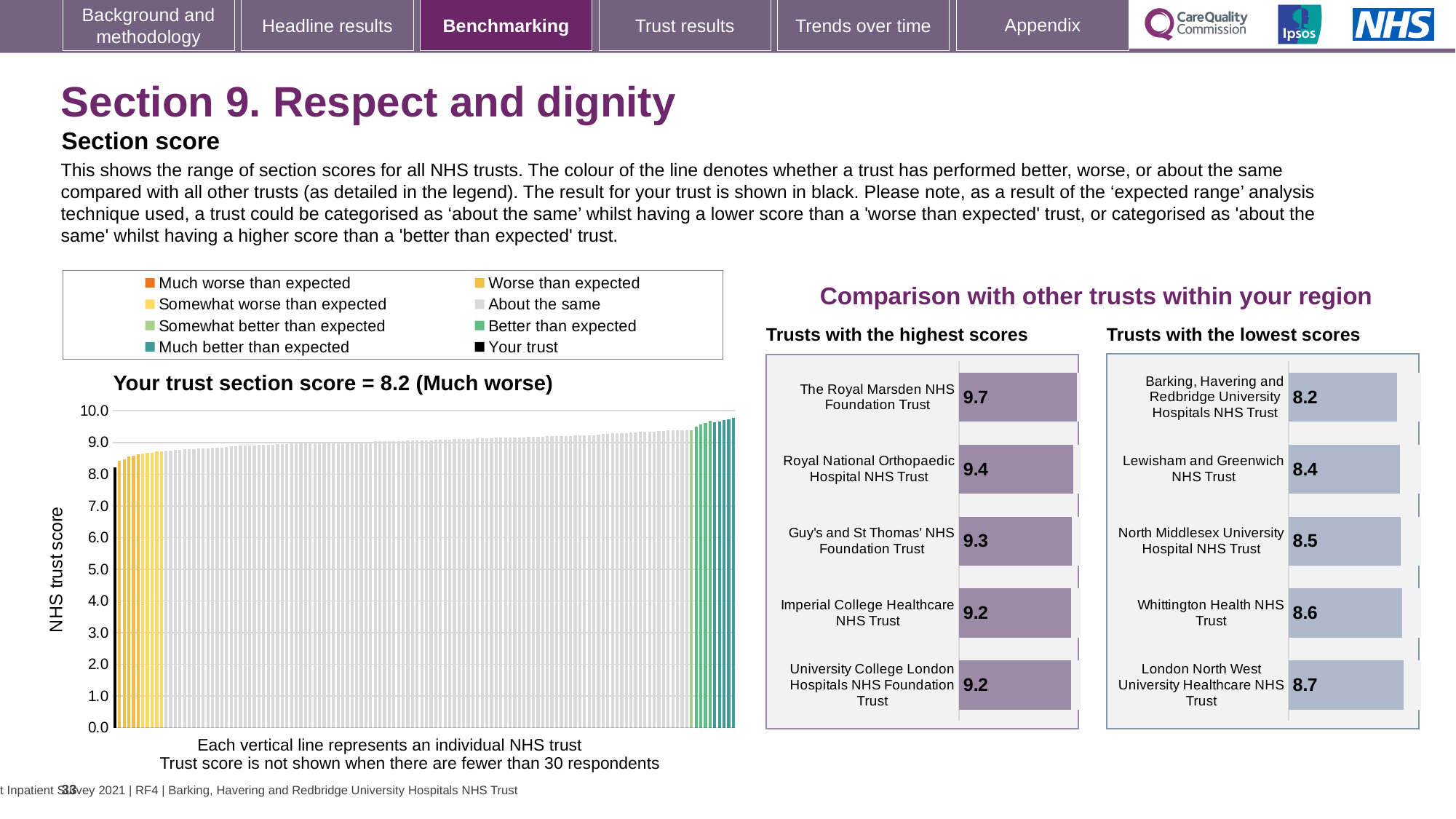
In the 'Trusts with the highest scores' chart, what is the difference between the scores of The Royal Marsden NHS Foundation Trust and Royal National Orthopaedic Hospital NHS Trust? 0.3 In the 'Trusts with the lowest scores' chart, which has the higher score: Whittington Health NHS Trust or Lewisham and Greenwich NHS Trust? Whittington Health NHS Trust In the 'Trusts with the lowest scores' chart, what is the difference between the scores of London North West University Healthcare NHS Trust and Barking, Havering and Redbridge University Hospitals NHS Trust? 0.5 In the 'Trusts with the lowest scores' chart, which trust has the lowest score? Barking, Havering and Redbridge University Hospitals NHS Trust In the 'Your trust section score' chart on the left, is the value of the tallest bar greater or less than 9.0? greater How many trusts are shown in the 'Trusts with the highest scores' chart? 5 How many entries does the legend above the 'Your trust section score' chart list? 8 In the 'Your trust section score' chart on the left, what is the section score for your trust? 8.2 In the 'Trusts with the highest scores' chart, what is the score for Guy's and St Thomas' NHS Foundation Trust? 9.3 In the 'Trusts with the highest scores' chart, what is the score for The Royal Marsden NHS Foundation Trust? 9.7 In the 'Trusts with the highest scores' chart, which trust has the highest score? The Royal Marsden NHS Foundation Trust In the 'Trusts with the lowest scores' chart, what is the score for Lewisham and Greenwich NHS Trust? 8.4